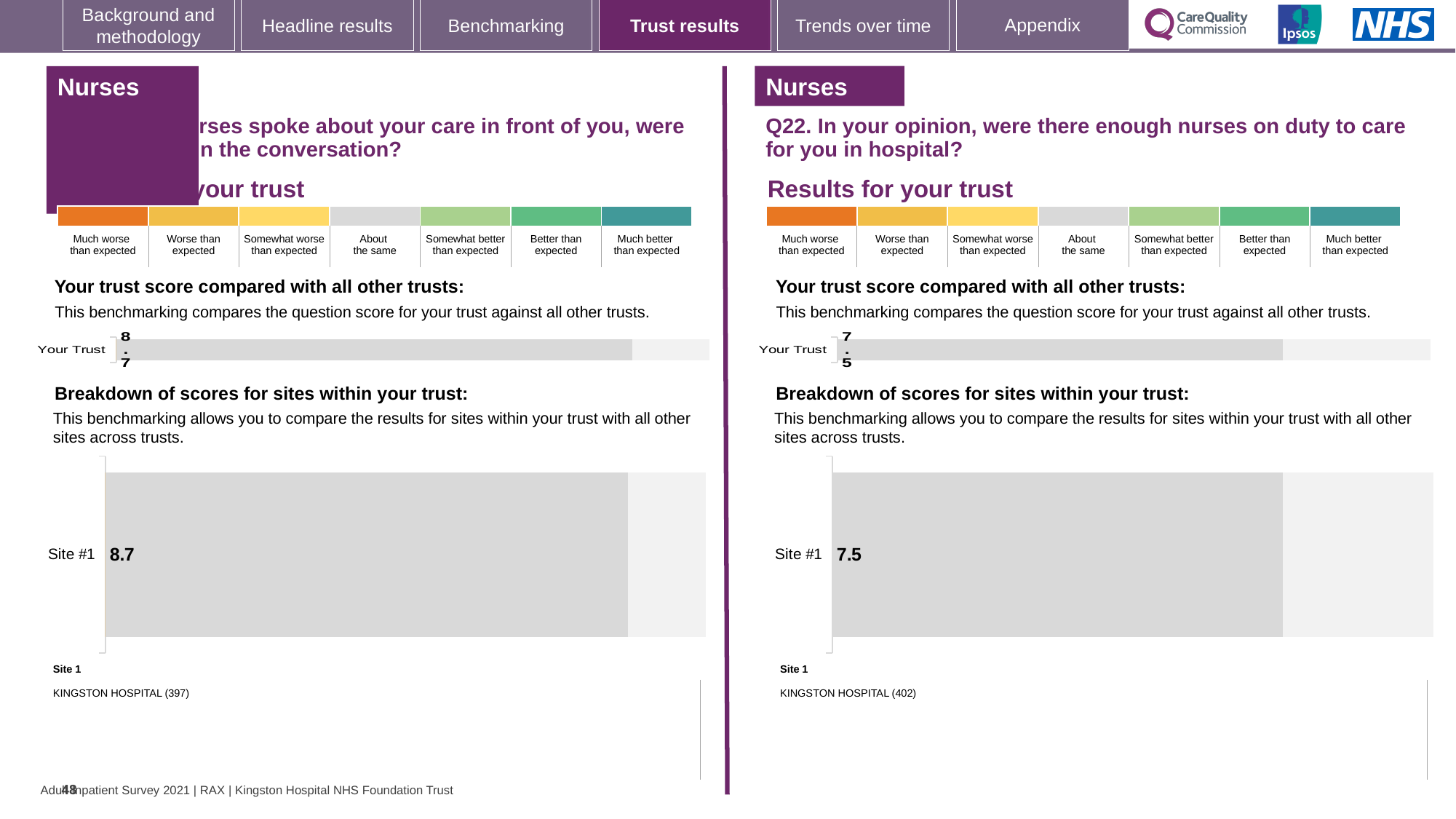
How many sites are shown in the left 'Breakdown of scores for sites within your trust' chart? 1 What is the difference between the Site #1 score in the left breakdown chart and the Site #1 score in the right (Q22) breakdown chart? 1.2 In the left 'Breakdown of scores for sites within your trust' chart, what is the value for Site #1? 8.7 How many sites are shown in the right (Q22) 'Breakdown of scores for sites within your trust' chart? 1 In the right 'Breakdown of scores for sites within your trust' chart (Q22), what is the value for Site #1? 7.5 Which 'Your Trust' score is higher: the one on the left half of the slide or the one on the right half (Q22)? The left half (8.7) Which Site #1 score is higher: the one in the left breakdown chart or the one in the right (Q22) breakdown chart? The left chart (8.7) On the right half of the slide (Q22), what score is shown for 'Your Trust' in the trust score comparison chart? 7.5 What site name is listed under 'Site 1' beneath the left breakdown chart? KINGSTON HOSPITAL (397) On the left half of the slide, what score is shown for 'Your Trust' in the trust score comparison chart? 8.7 What site name is listed under 'Site 1' beneath the right (Q22) breakdown chart? KINGSTON HOSPITAL (402) What type of chart is used to show the Site #1 score in the breakdown charts? Bar chart